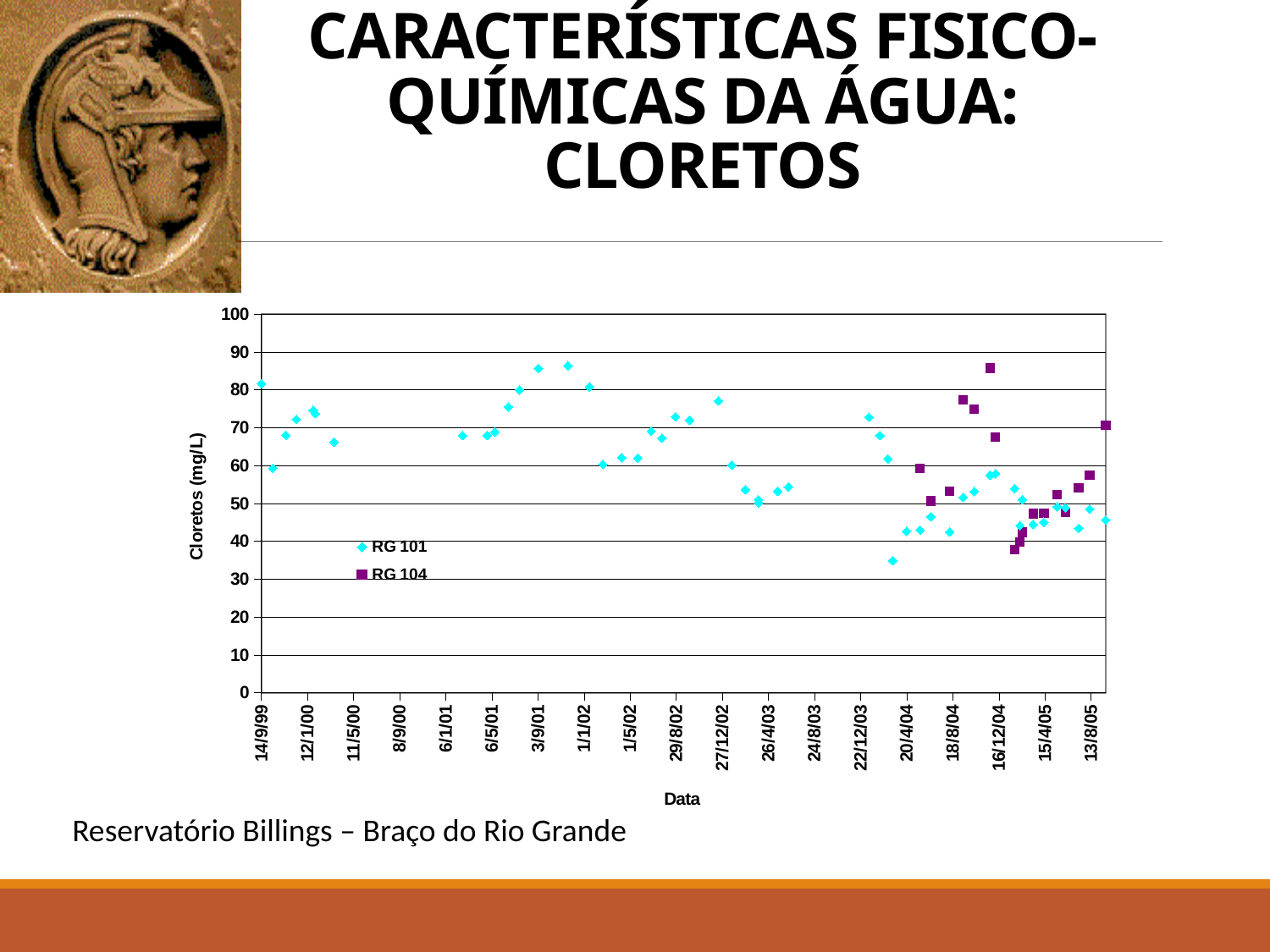
Overall, do the RG 101 values rise or fall from 1999 to 2005? fall Which is larger for RG 101: the first value at 14/9/99 or the last value at 13/8/05? the first value at 14/9/99 Is the lowest RG 104 value, plotted just after 16/12/04, greater or less than 50? less Is the highest RG 104 value, plotted near 16/12/04, greater or less than 80? greater What kind of chart is shown on the slide? scatter chart Is the last RG 104 value, at 13/8/05, greater or less than 60? greater How many series does the legend list? 2 At 13/8/05, which series has the larger value, RG 101 or RG 104? RG 104 What is the title of the vertical axis? Cloretos (mg/L) What are the two series named in the legend? RG 101 and RG 104